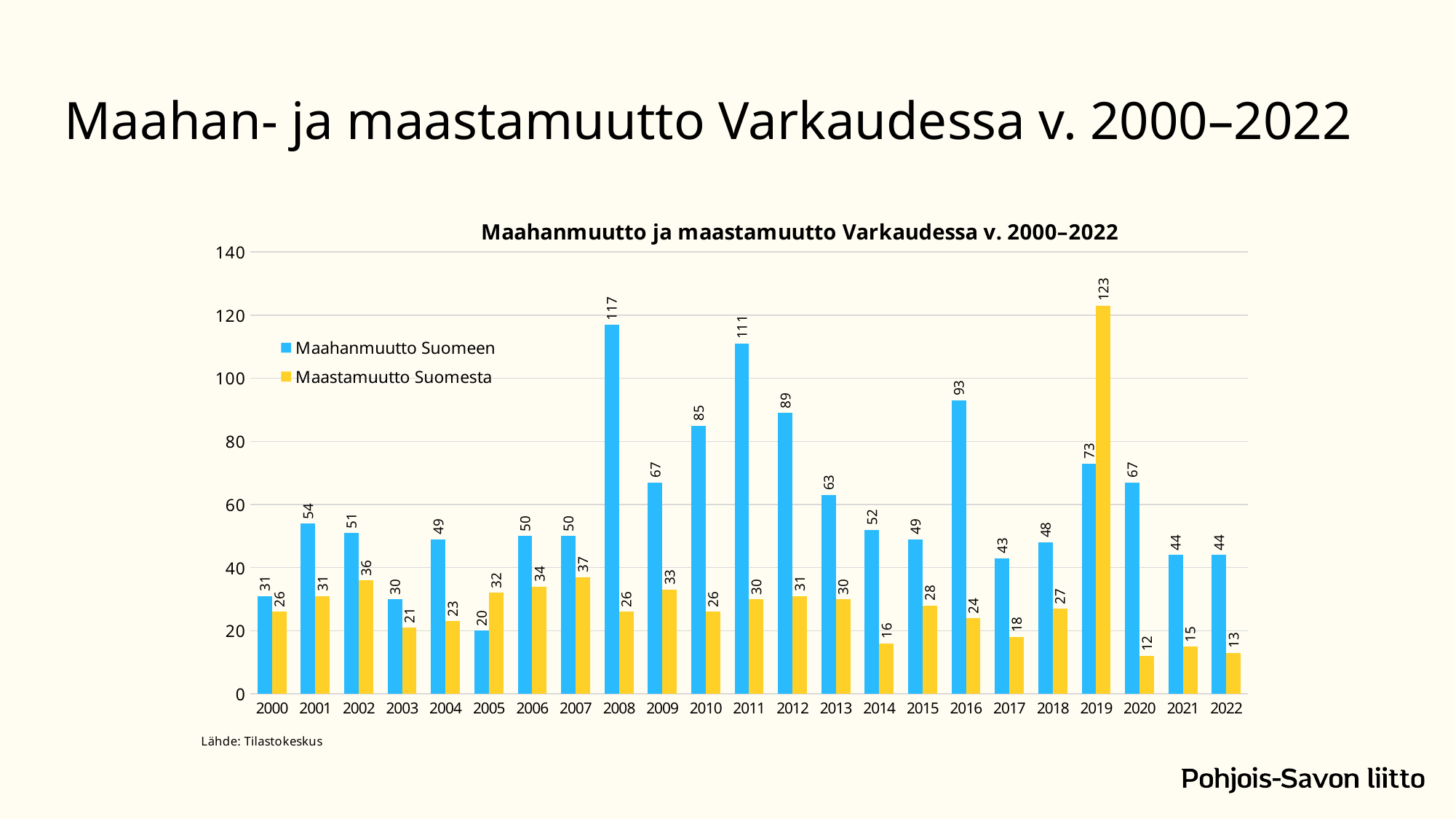
In 2019, which is larger: Maahanmuutto Suomeen or Maastamuutto Suomesta? Maastamuutto Suomesta Is the value for Maahanmuutto Suomeen in 2016 greater or less than 80? greater What is the difference between Maahanmuutto Suomeen and Maastamuutto Suomesta in 2011? 81 What is the value of Maahanmuutto Suomeen in 2005? 20 What is the value of Maahanmuutto Suomeen in 2008? 117 What kind of chart is shown on the slide? Bar chart How many years are shown on the x axis? 23 Which year has the lowest value for Maastamuutto Suomesta? 2020 What is the value of Maastamuutto Suomesta in 2019? 123 What is the title of the chart? Maahanmuutto ja maastamuutto Varkaudessa v. 2000–2022 How many series does the legend list? 2 Which year has the highest value for Maahanmuutto Suomeen? 2008